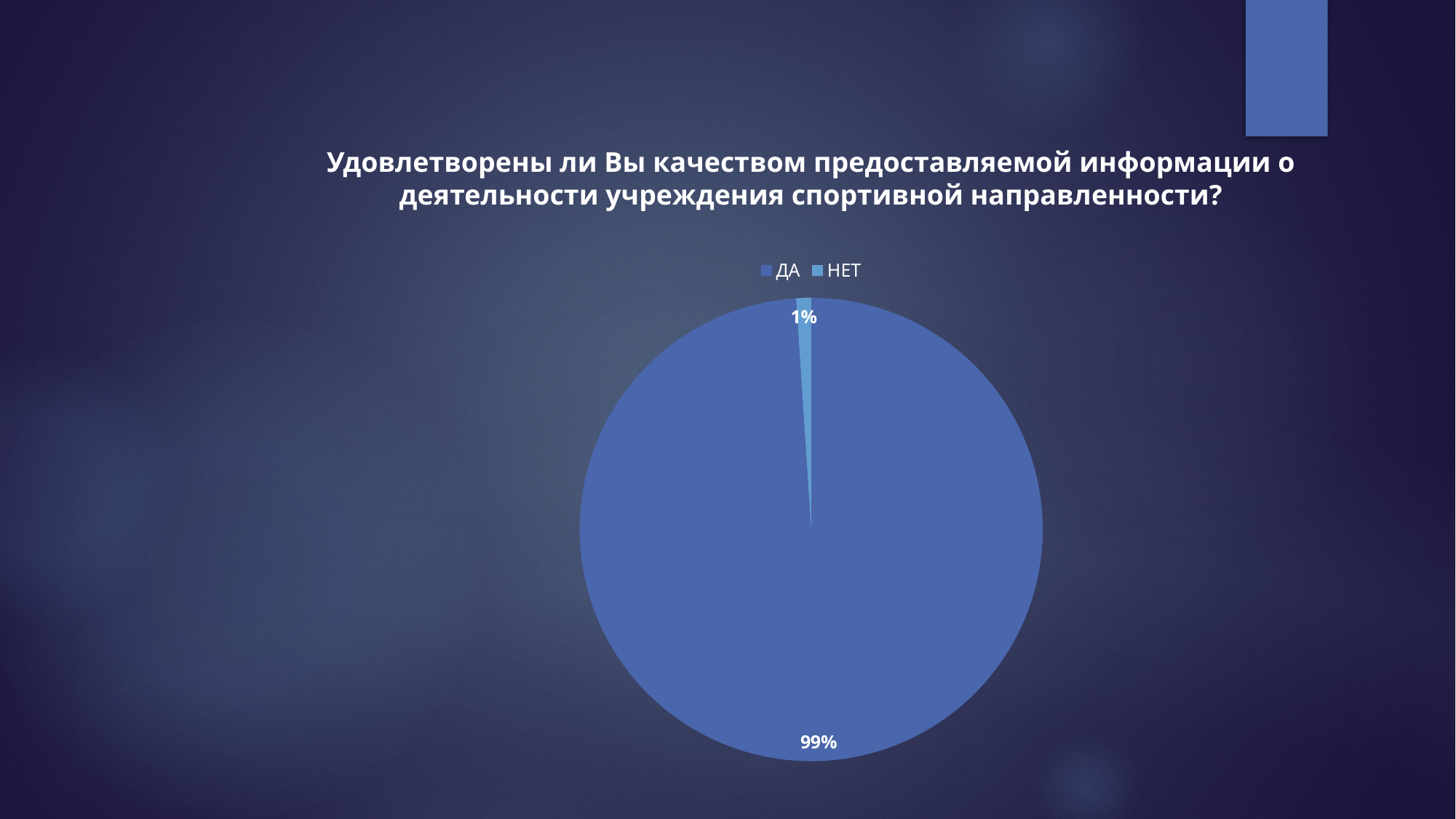
What is the difference in percentage points between the ДА and НЕТ slices? 98 Which is larger, the ДА slice or the НЕТ slice? ДА What share of the pie does ДА represent? 99% What are the two legend entries of the chart? ДА and НЕТ What kind of chart is shown on the slide? pie chart Which category has the largest slice of the pie? ДА How many categories does the pie chart show? 2 What is the title of the chart? Удовлетворены ли Вы качеством предоставляемой информации о деятельности учреждения спортивной направленности? How many entries does the legend list? 2 What share of the pie does НЕТ represent? 1% Which category has the smallest slice of the pie? НЕТ